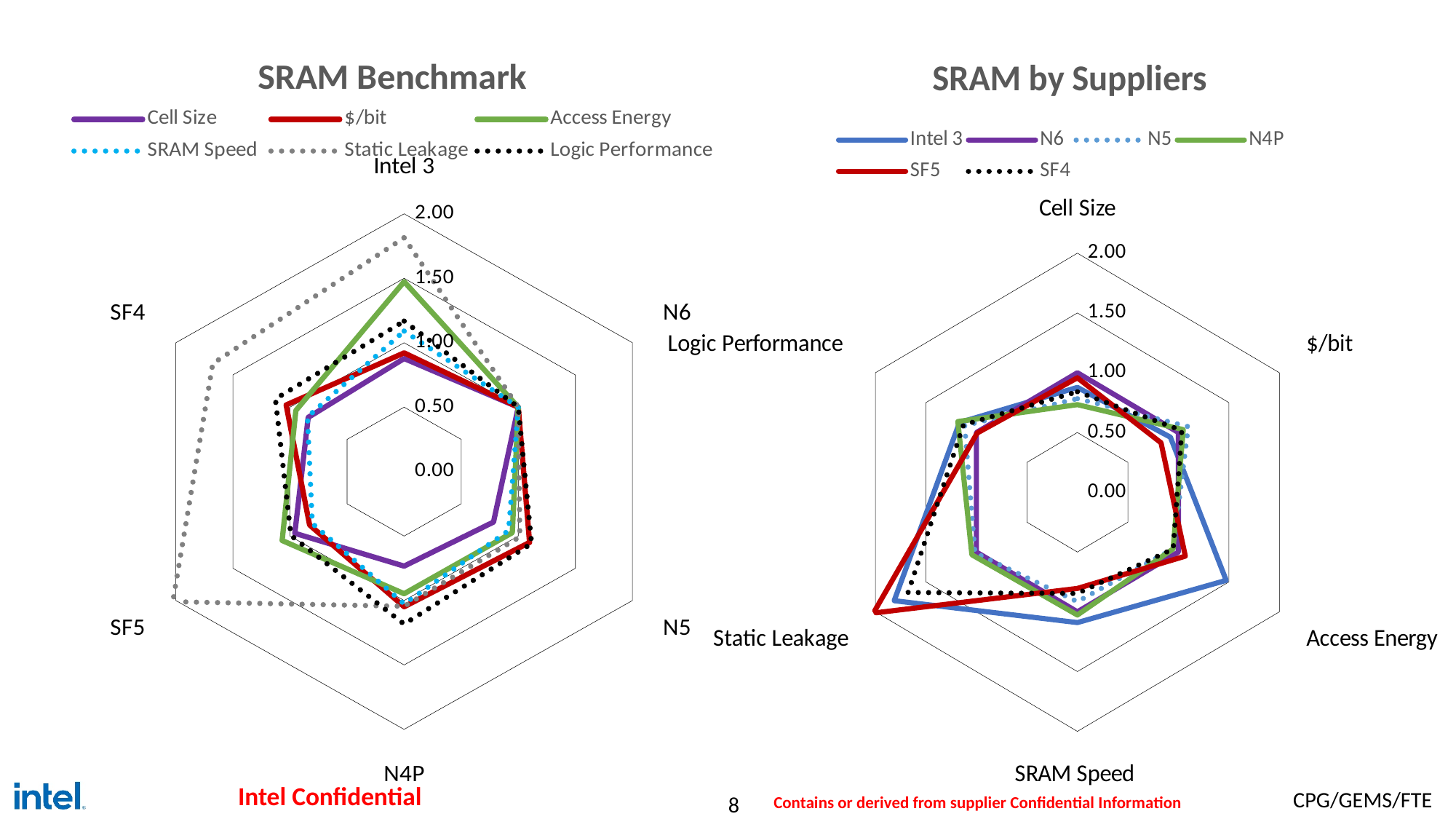
How many series does the legend of the SRAM by Suppliers chart list? 6 What kind of chart is the SRAM Benchmark chart on the left? radar chart In the SRAM Benchmark chart, is the Static Leakage value for SF5 greater or less than 1.50? greater What is the maximum value shown on the axis scale of the SRAM by Suppliers chart? 2.00 How many axis categories does the SRAM Benchmark chart have? 6 In the SRAM by Suppliers chart, is the SF5 value for Static Leakage greater or less than 1.50? greater In the SRAM by Suppliers chart, is the N4P value for Cell Size greater or less than 1.00? less How many series does the legend of the SRAM Benchmark chart list? 6 How many axis categories does the SRAM by Suppliers chart have? 6 What kind of chart is the SRAM by Suppliers chart on the right? radar chart